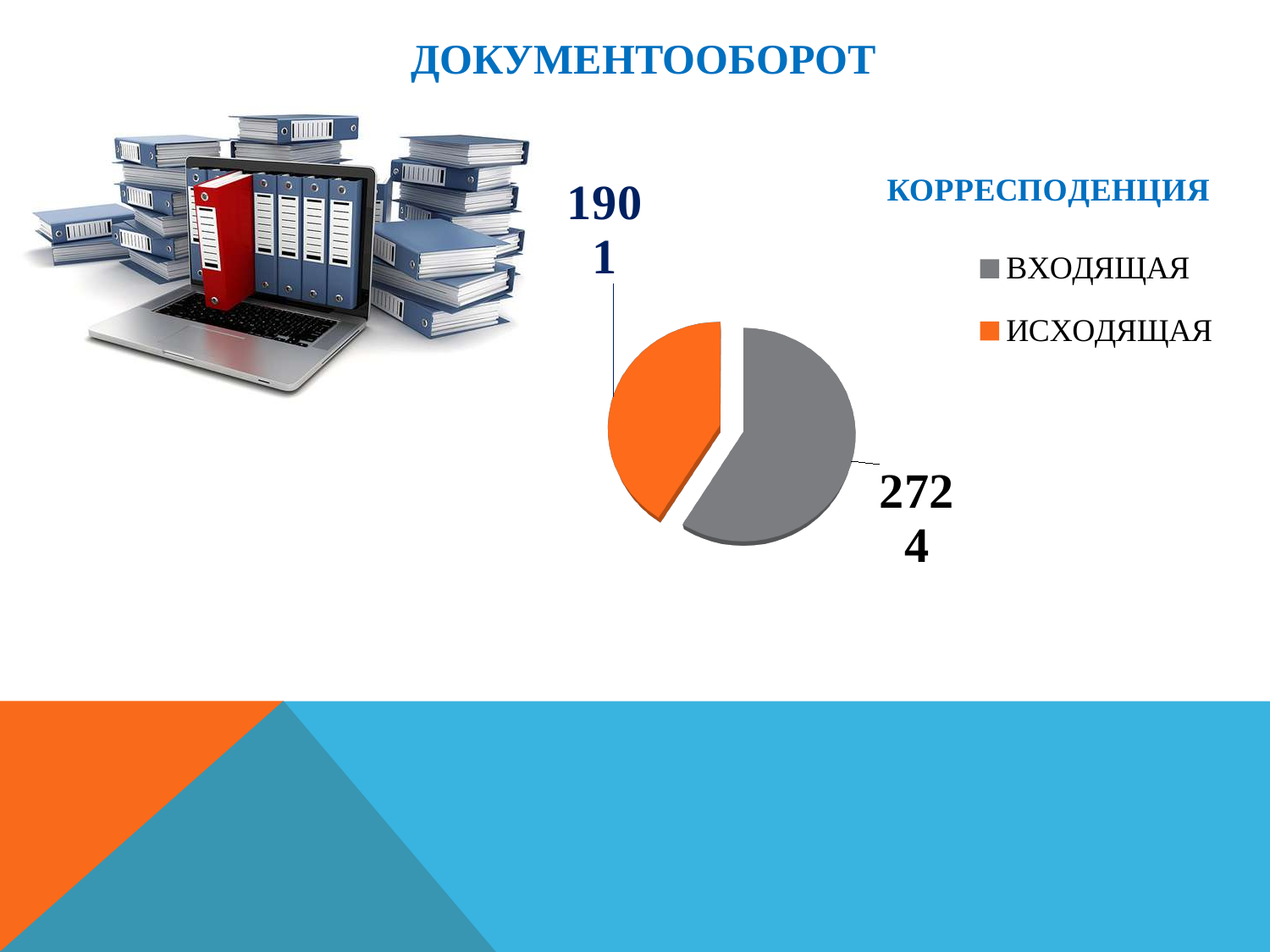
Which category has the smallest slice? ИСХОДЯЩАЯ What type of chart is shown on the slide? pie chart Which colour represents ИСХОДЯЩАЯ in the chart? orange What is the value for ИСХОДЯЩАЯ? 1901 Which is larger, ВХОДЯЩАЯ or ИСХОДЯЩАЯ? ВХОДЯЩАЯ How many series does the chart legend list? 2 What is the value for ВХОДЯЩАЯ? 2724 Which category has the largest slice? ВХОДЯЩАЯ How many slices does the pie chart have? 2 What is the total of the two values shown in the pie chart? 4625 What is the title of the chart? КОРРЕСПОДЕНЦИЯ What is the difference between the values for ВХОДЯЩАЯ and ИСХОДЯЩАЯ? 823